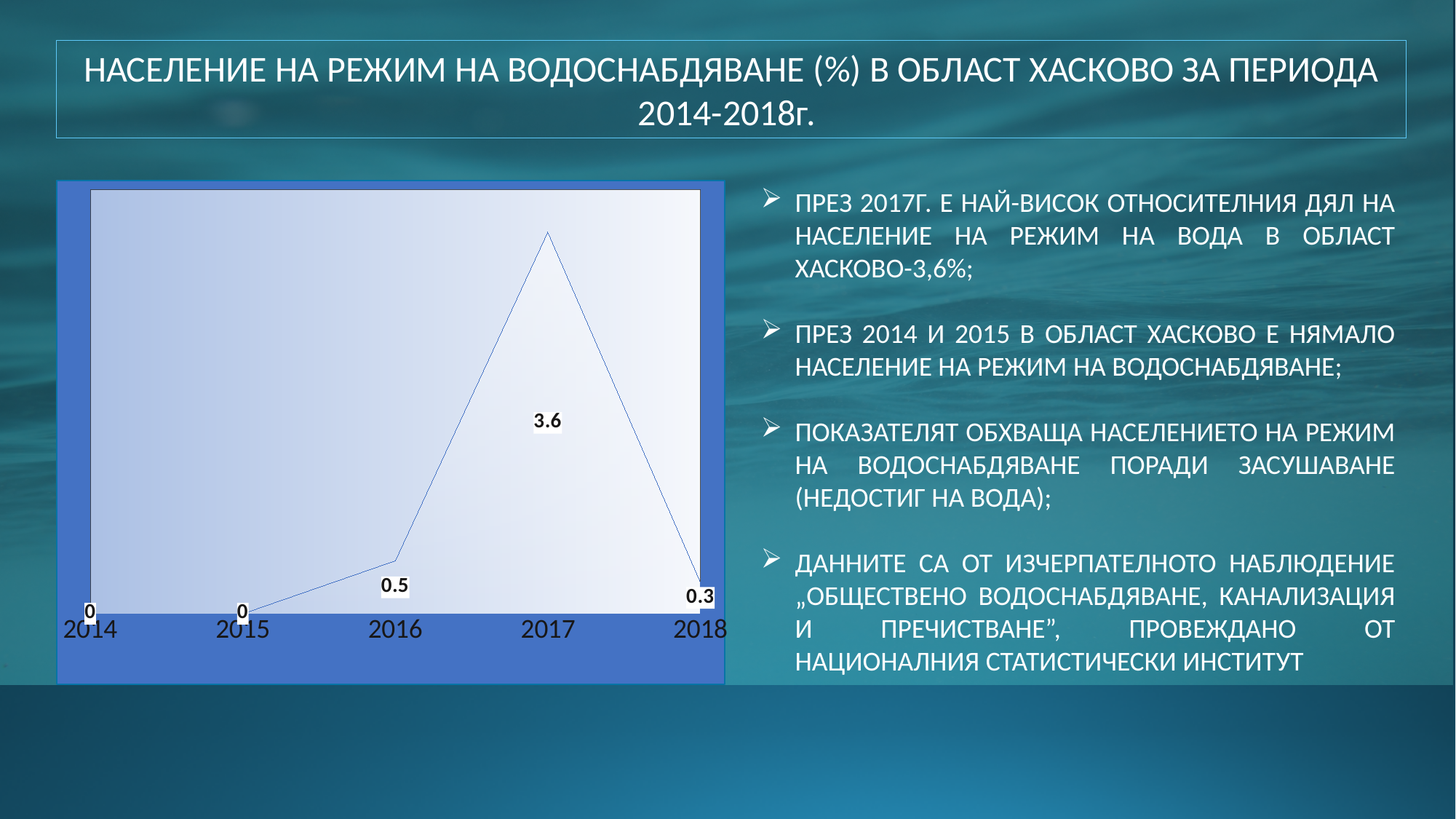
Which year has the highest value? 2017 Which two years have a value of 0? 2014 and 2015 Does the value rise or fall from 2017 to 2018? fall What is the value for 2018? 0.3 How many years are plotted on the x axis? 5 What kind of chart is shown on the slide? area chart What is the value for 2014? 0 What is the difference between the values for 2017 and 2016? 3.1 What is the difference between the values for 2016 and 2018? 0.2 Which is larger, the value for 2016 or the value for 2018? 2016 What is the value for 2016? 0.5 What is the value for 2017? 3.6